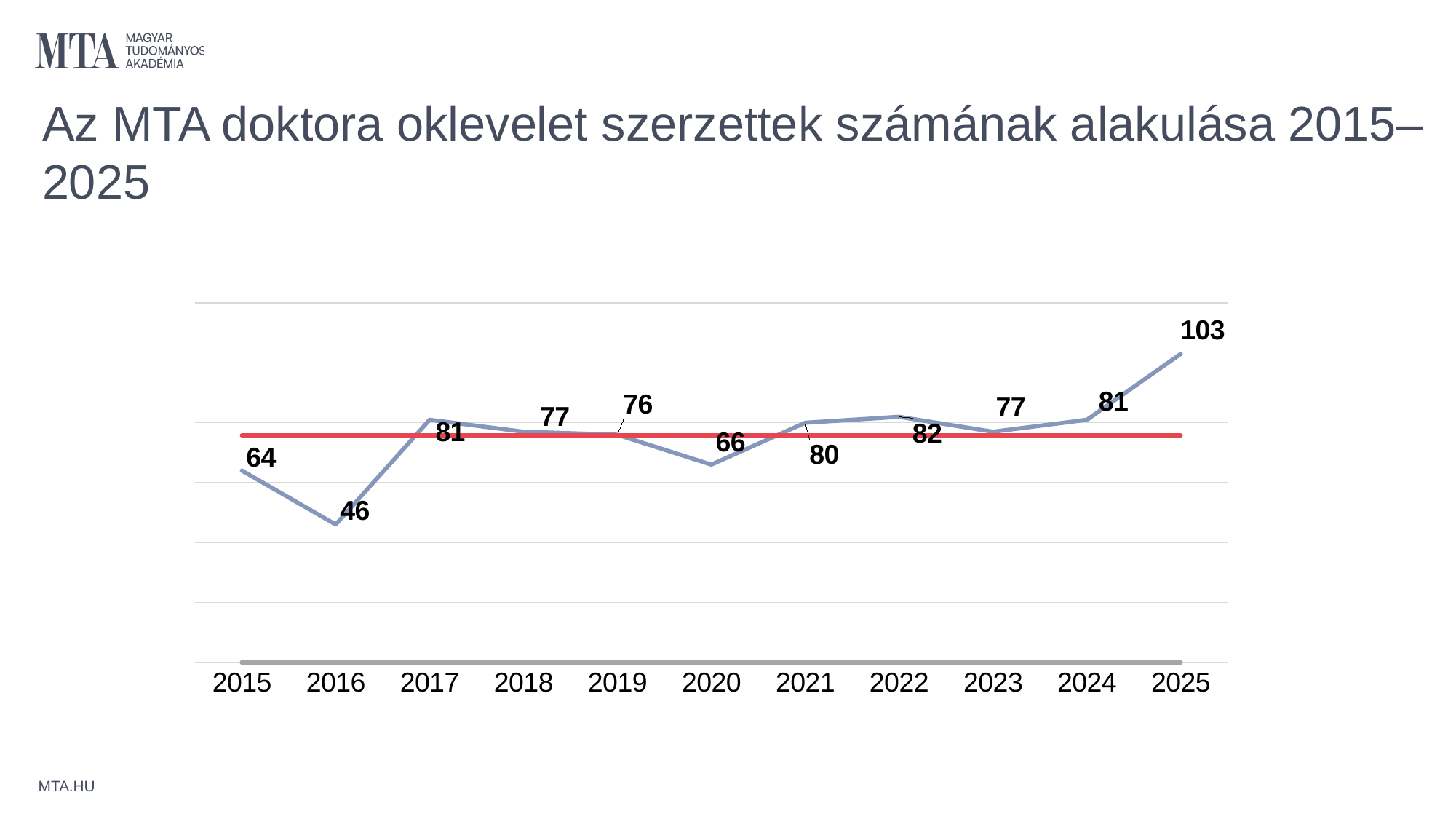
Which is larger, the value for 2017 or the value for 2020? 2017 What is the value for 2025? 103 Does the value rise or fall from 2023 to 2025? rise What is the value for 2020? 66 What is the difference between the values for 2025 and 2024? 22 How many years are plotted on the x axis? 11 What is the difference between the values for 2015 and 2016? 18 Which year has the highest value? 2025 What is the value for 2022? 82 What is the value for 2016? 46 What kind of chart is shown on the slide? line chart Which year has the lowest value? 2016